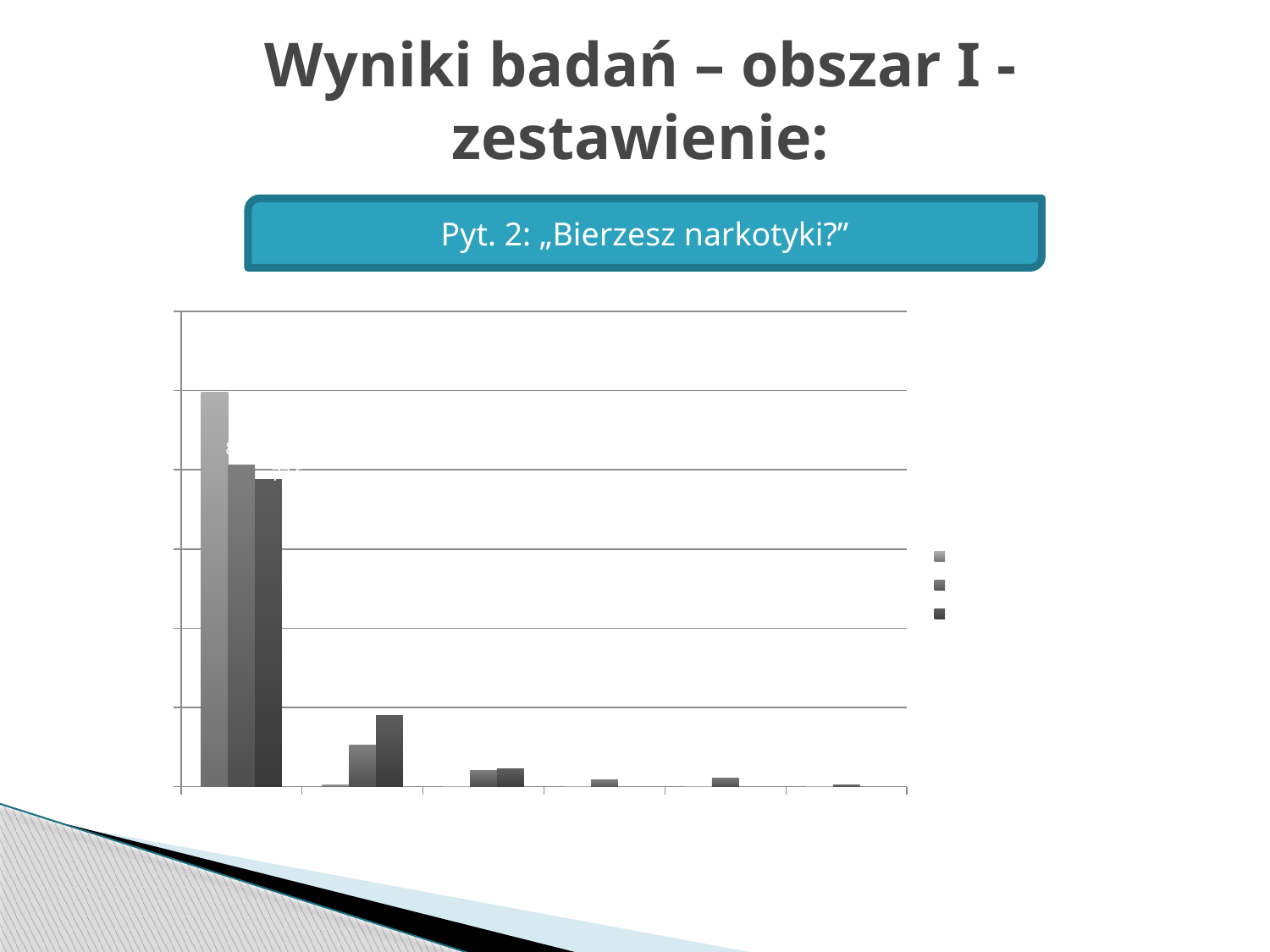
Do the bar heights generally rise or fall moving from left to right along the x axis? fall What is the title of the slide? Wyniki badań – obszar I - zestawienie: How many series does the legend of the chart list? 3 What kind of chart is shown on the slide? bar chart What survey question is shown in the box above the chart? Pyt. 2: „Bierzesz narkotyki?” Which category group, counted from the left, has the tallest bars? the first Within the second category group, is the rightmost bar taller or shorter than the middle bar? taller Within the first category group, is the leftmost bar taller or shorter than the rightmost bar? taller How many category groups are plotted along the x axis of the chart? 6